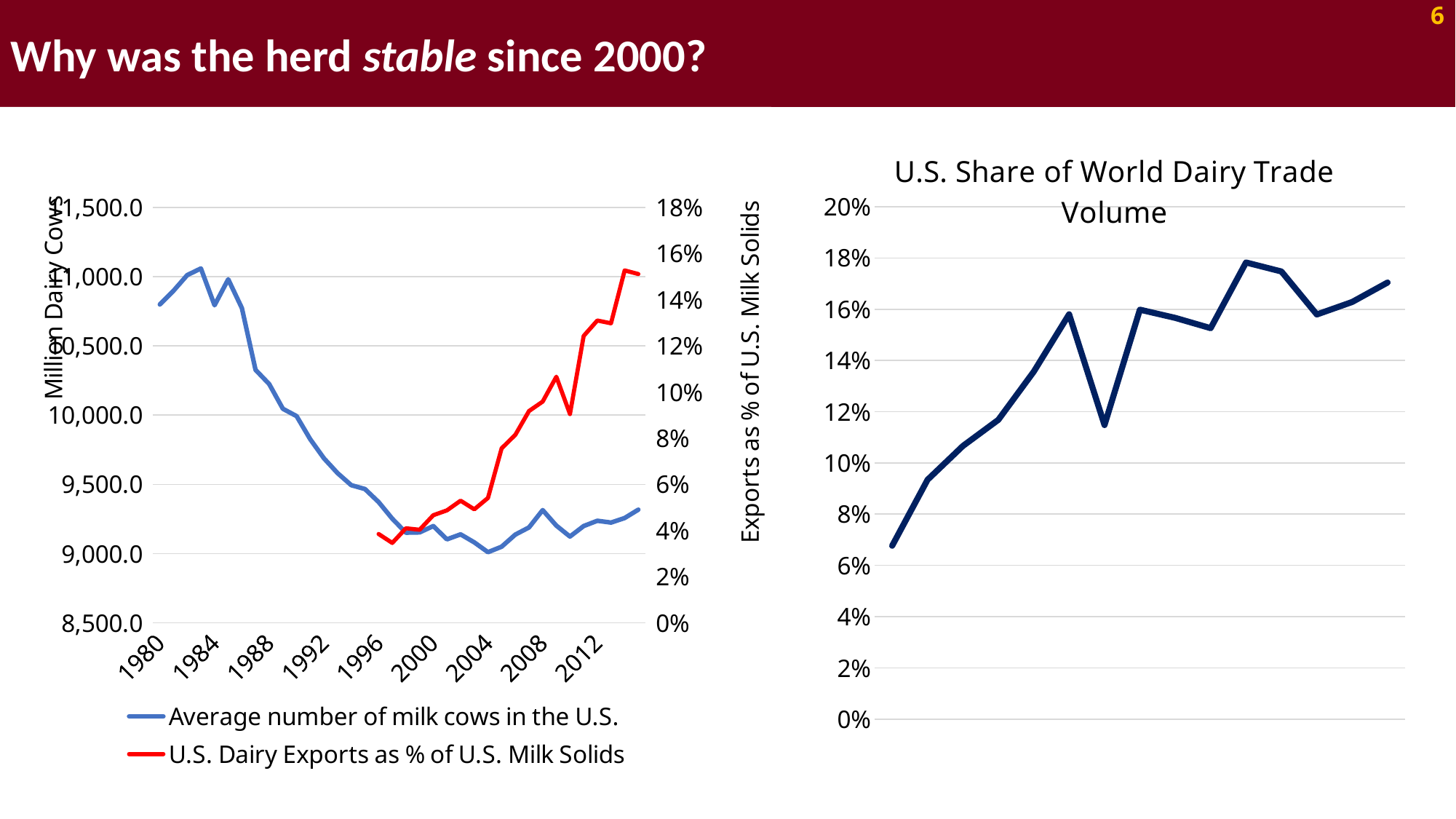
On the U.S. Share of World Dairy Trade Volume chart, is the first plotted value greater or less than 8%? less On the left chart, is the value for Average number of milk cows in the U.S. in 2000 greater or less than 9,500.0? less On the left chart, is the value for U.S. Dairy Exports as % of U.S. Milk Solids in 2000 greater or less than 6%? less What is the title of the right chart? U.S. Share of World Dairy Trade Volume On the left chart, does U.S. Dairy Exports as % of U.S. Milk Solids rise or fall between 2004 and 2012? rise What kind of chart is the left chart on the slide? line chart On the left chart, does the Average number of milk cows in the U.S. rise or fall between 1984 and 2000? fall What kind of chart is the U.S. Share of World Dairy Trade Volume chart? line chart How many series does the legend of the left chart list? 2